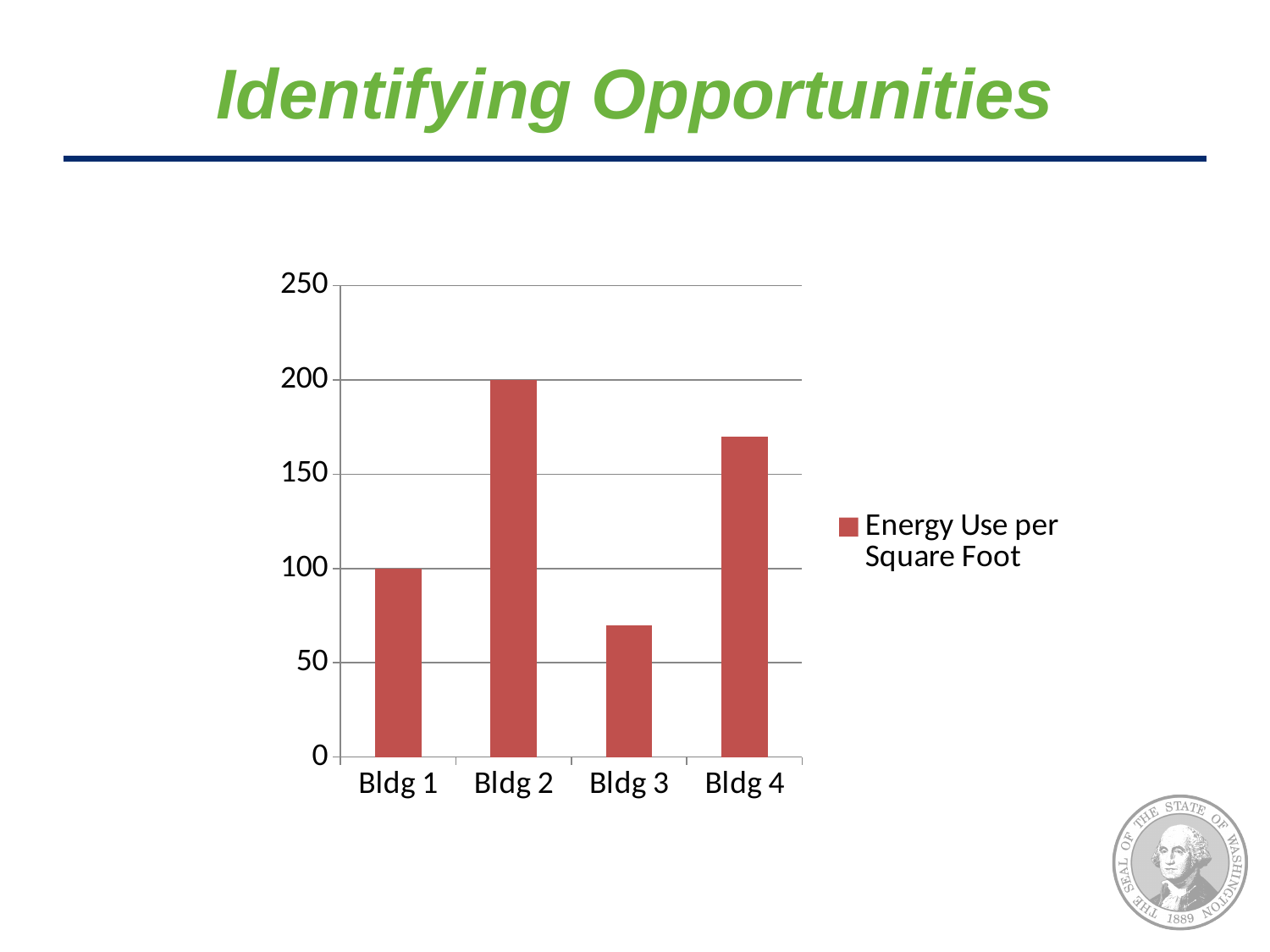
Which building has the lowest energy use per square foot? Bldg 3 What is the value for Bldg 2? 200 What is the name of the series shown in the legend? Energy Use per Square Foot How many series does the legend list? 1 Which building has the highest energy use per square foot? Bldg 2 What kind of chart is shown on the slide? bar chart How many buildings are plotted on the chart? 4 What is the difference between the values for Bldg 2 and Bldg 1? 100 What is the value for Bldg 1? 100 Is the value for Bldg 4 greater or less than 150? greater Is the value for Bldg 3 greater or less than 100? less Which is larger, the value for Bldg 4 or the value for Bldg 1? Bldg 4